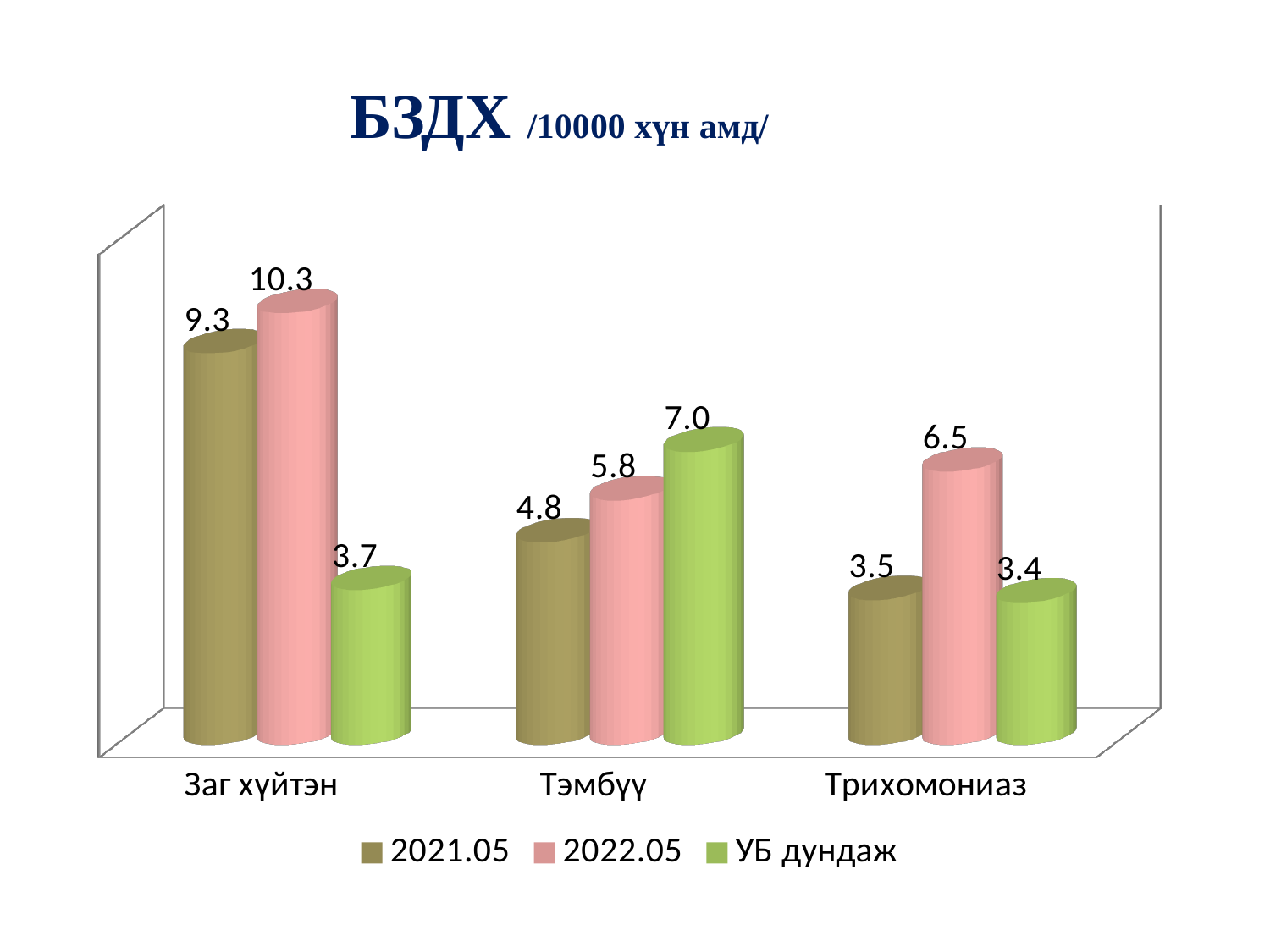
What is the difference between the УБ дундаж value and the 2022.05 value for Тэмбүү? 1.2 What is the value for Тэмбүү in the 2021.05 series? 4.8 How many series does the legend list? 3 What is the value for Заг хүйтэн in the 2022.05 series? 10.3 What is the УБ дундаж value for Трихомониаз? 3.4 What is the difference between the 2022.05 and 2021.05 values for Заг хүйтэн? 1.0 How many categories are shown on the x axis? 3 Which category has the highest value in the 2021.05 series? Заг хүйтэн Which category has the lowest value in the УБ дундаж series? Трихомониаз What is the value for Трихомониаз in the 2022.05 series? 6.5 What kind of chart is shown on the slide? Bar chart Which is larger for Тэмбүү: the 2022.05 value or the УБ дундаж value? УБ дундаж